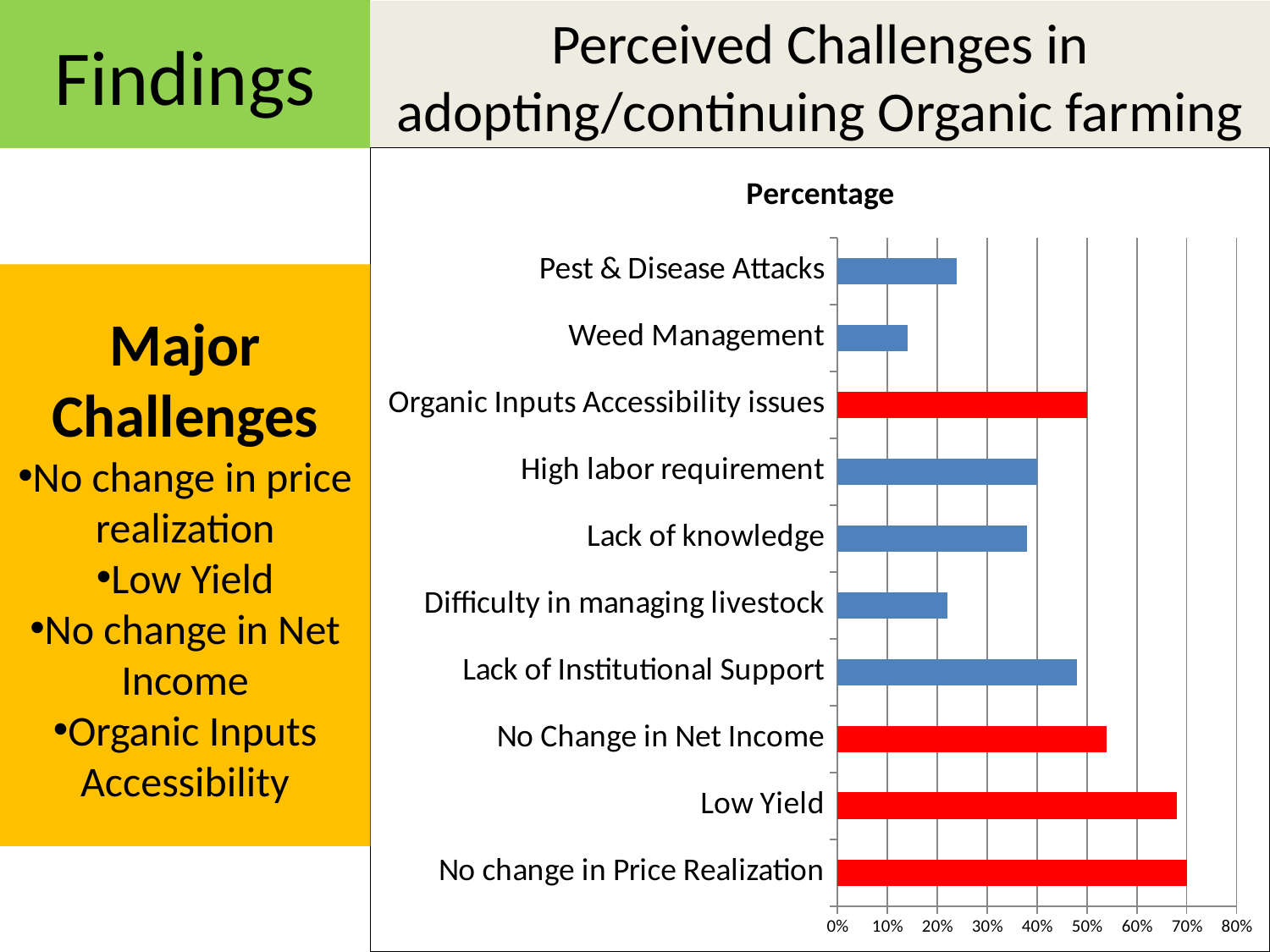
Which is larger, the value for Pest & Disease Attacks or the value for High labor requirement? High labor requirement Is the value for Lack of Institutional Support greater or less than 40%? greater What kind of chart is shown on the slide? bar chart Is the value for Weed Management greater or less than 20%? less Is the value for Pest & Disease Attacks greater or less than 30%? less What is the title of the chart? Percentage Which challenge has the highest percentage in the chart? No change in Price Realization How many challenge categories are plotted in the chart? 10 Which is larger, the value for Lack of knowledge or the value for Difficulty in managing livestock? Lack of knowledge Which challenge has the lowest percentage in the chart? Weed Management